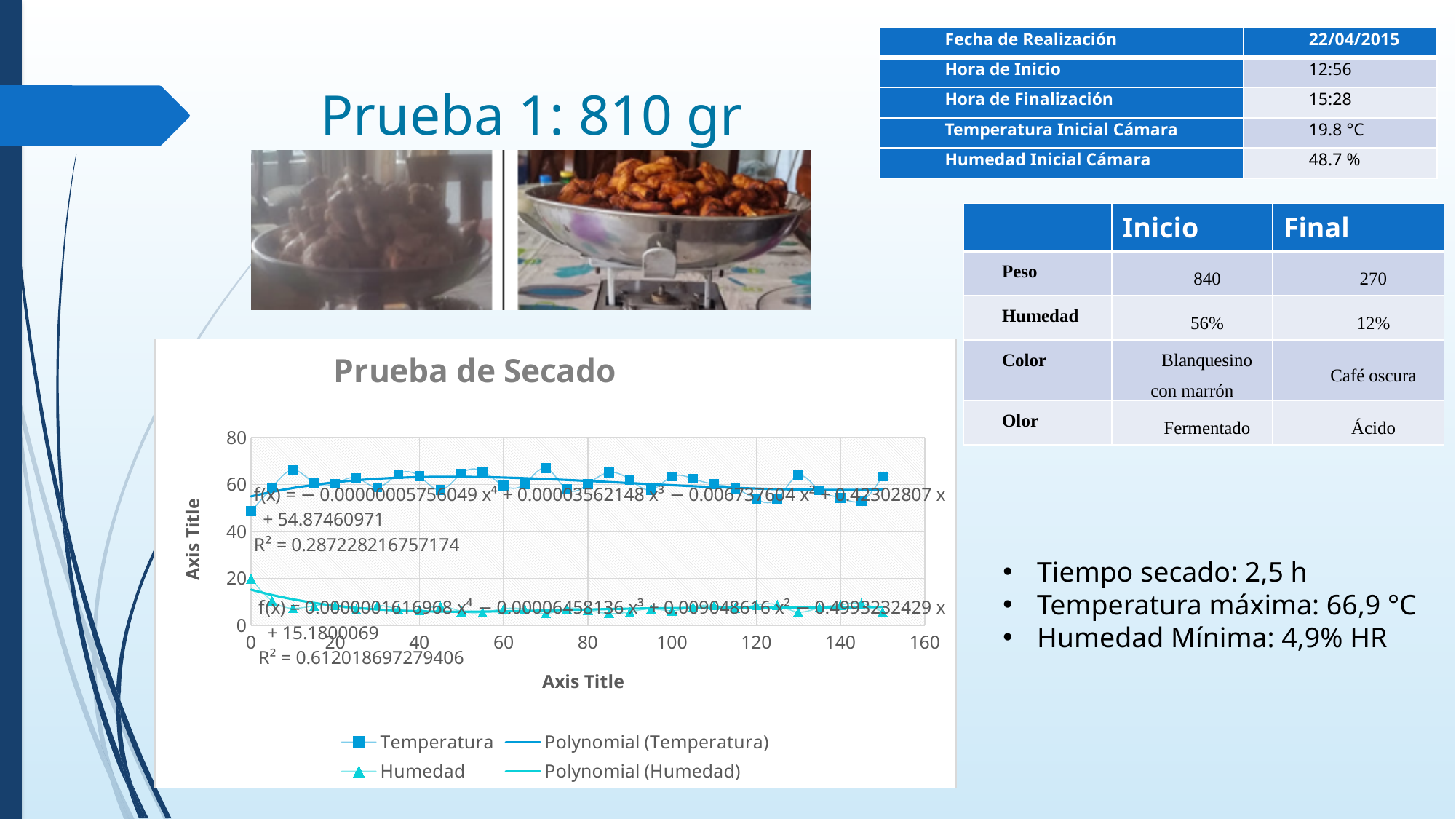
In the Prueba de Secado chart, is the Temperatura value at x = 0 greater or less than 60? less What kind of chart is Prueba de Secado? line chart In the Prueba de Secado chart, are all Temperatura values greater or less than 80? less What is the title of the chart on the slide? Prueba de Secado What is the highest value shown on the x axis of the Prueba de Secado chart? 160 How many series does the legend of the Prueba de Secado chart list? 4 In the Prueba de Secado chart, is the Humedad value at x = 0 greater or less than 10? greater What is the R² value shown for the Humedad polynomial trendline in the Prueba de Secado chart? 0.612018697279406 In the Prueba de Secado chart, do the Humedad values rise or fall along the x axis? fall What is the R² value shown for the Temperatura polynomial trendline in the Prueba de Secado chart? 0.287228216757174 In the Prueba de Secado chart, which series has the higher values, Temperatura or Humedad? Temperatura